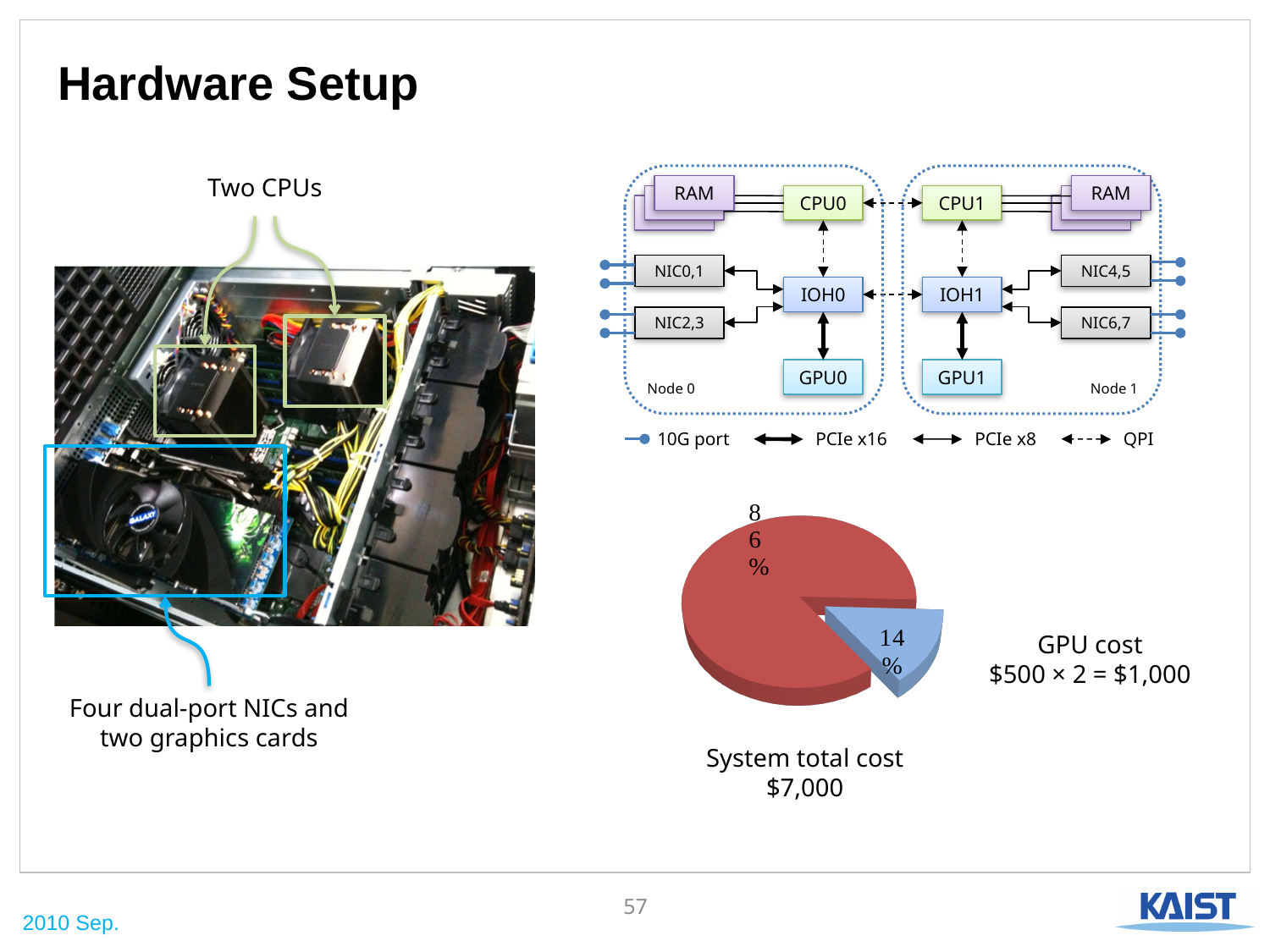
What kind of chart is shown at the bottom right of the slide? pie chart What percentage is shown on the red slice of the pie chart? 86% Which slice of the pie chart is larger, the red one or the blue one? the red one What GPU cost calculation is shown next to the pie chart? $500 × 2 = $1,000 Is the blue slice of the pie chart greater or less than 50%? less How many slices does the pie chart have? 2 What system total cost is stated below the pie chart? $7,000 Which slice of the pie chart is the largest? the red slice (86%) What percentage is shown on the blue slice of the pie chart? 14% Which slice of the pie chart is the smallest? the blue slice (14%) By how many percentage points does the red slice exceed the blue slice in the pie chart? 72 percentage points